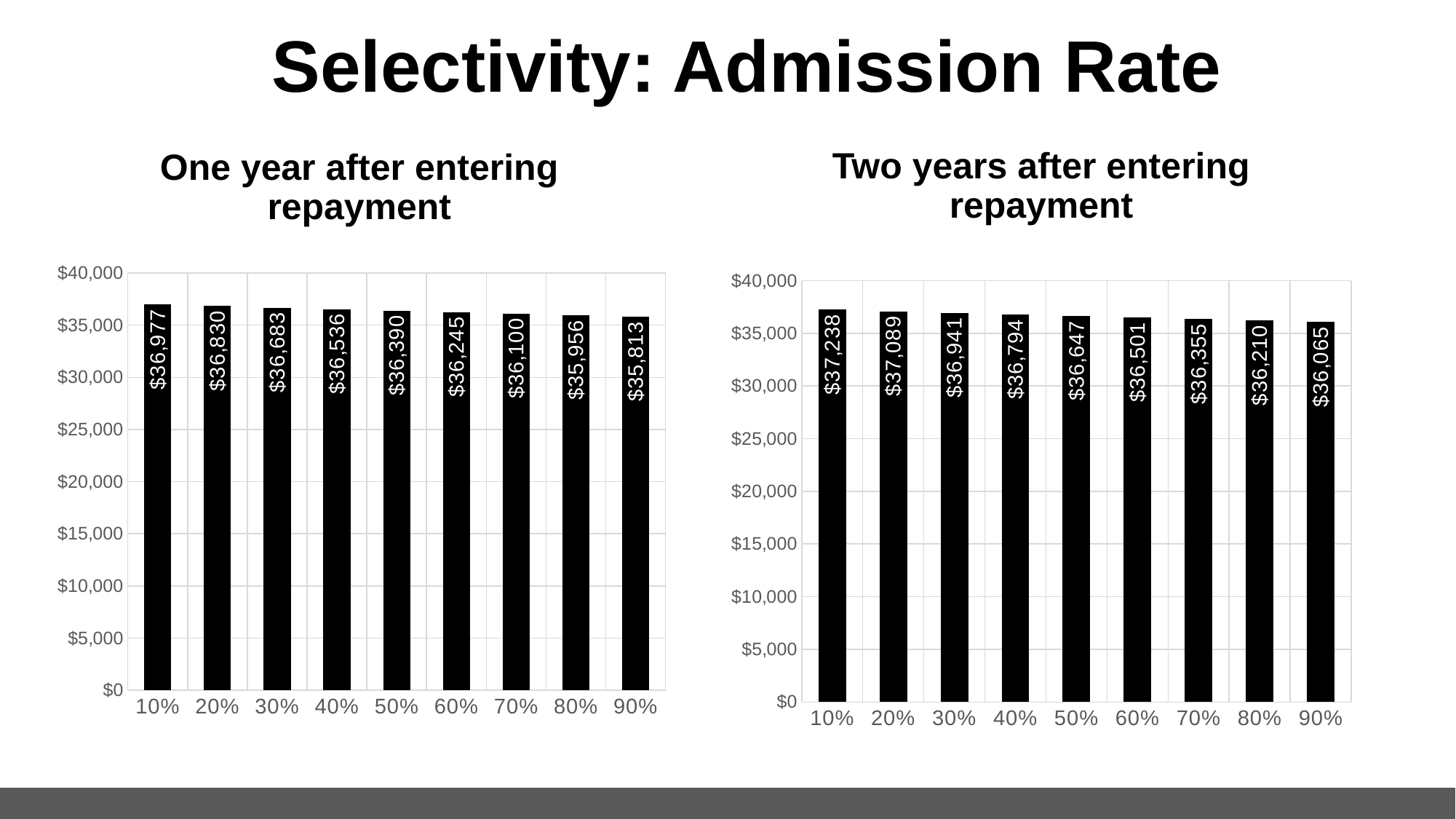
In the 'Two years after entering repayment' chart, what is the difference between the values for 10% and 90%? $1,173 In the 'One year after entering repayment' chart, what is the value for 10%? $36,977 What kind of chart is the 'One year after entering repayment' chart? bar chart In the 'One year after entering repayment' chart, which admission rate has the lowest value? 90% In the 'Two years after entering repayment' chart, which admission rate has the highest value? 10% In the 'One year after entering repayment' chart, is the value for 60% greater or less than $35,000? greater How many admission rate categories are shown in the 'Two years after entering repayment' chart? 9 In the 'Two years after entering repayment' chart, what is the value for 50%? $36,647 Which is larger: the value for 30% in the 'One year after entering repayment' chart or the value for 30% in the 'Two years after entering repayment' chart? Two years after entering repayment In the 'One year after entering repayment' chart, what is the difference between the values for 40% and 50%? $146 In the 'One year after entering repayment' chart, what is the value for 90%? $35,813 In the 'Two years after entering repayment' chart, do the values rise or fall as the admission rate increases from 10% to 90%? fall